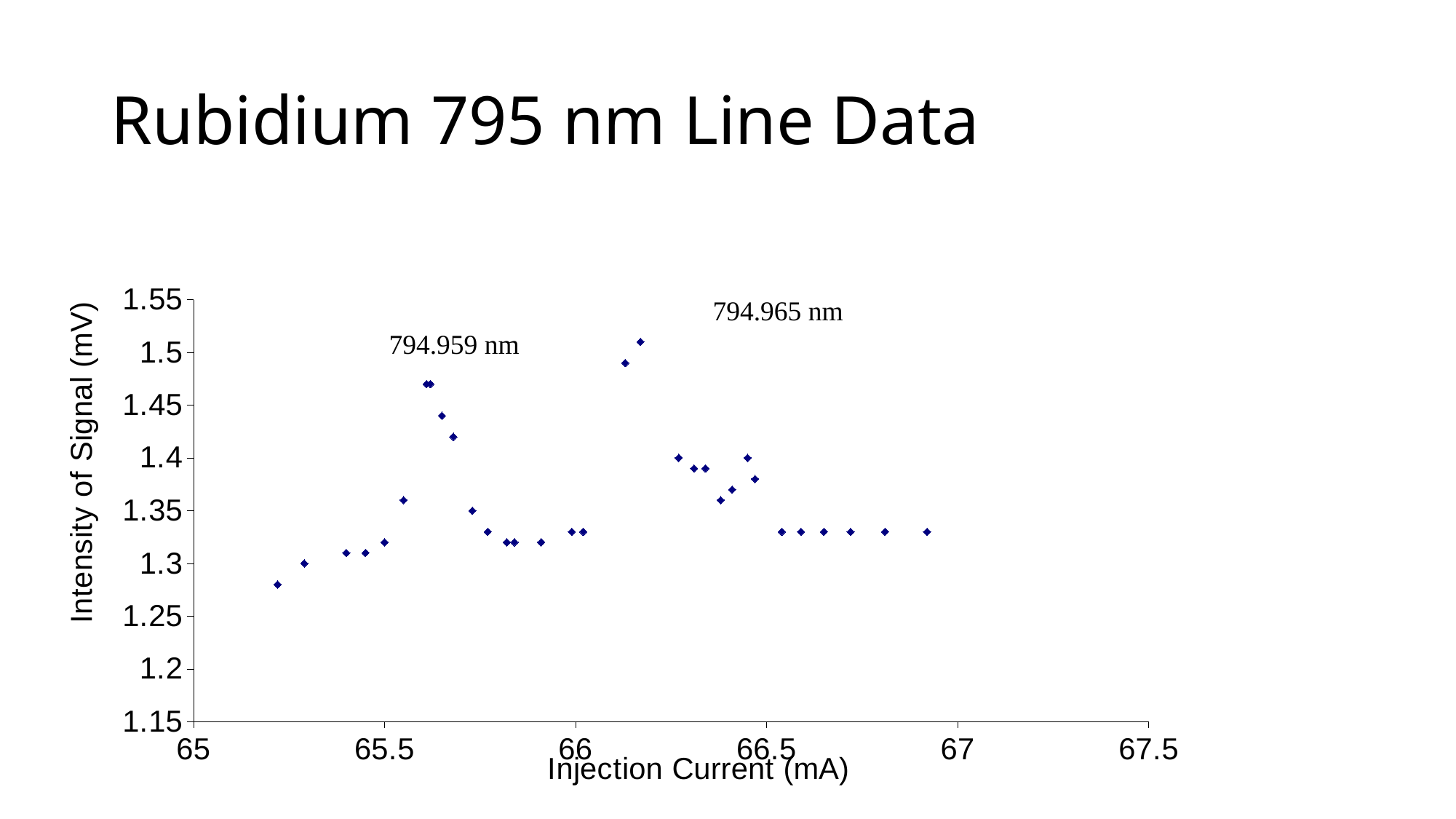
Which of the two labelled peaks reaches a higher intensity, the one labelled 794.959 nm or the one labelled 794.965 nm? 794.965 nm What is the maximum value shown on the x axis? 67.5 Is the peak intensity of the 794.959 nm feature greater or less than 1.4 mV? greater Do the intensity values rise or fall as the injection current increases from about 65.6 mA to 65.8 mA? fall Do the intensity values rise or fall as the injection current increases from about 65.2 mA to 65.6 mA? rise What is the title of the chart on the slide? Rubidium 795 nm Line Data What kind of chart is shown on the slide? Scatter plot Near which injection current does the highest intensity point occur: closer to 65.6 mA or closer to 66.2 mA? 66.2 mA What is the label of the x axis? Injection Current (mA) Are the plotted points between 66.5 mA and 67 mA greater or less than 1.4 mV? less Is the lowest plotted intensity value (at the far left, near 65.2 mA) greater or less than 1.35 mV? less